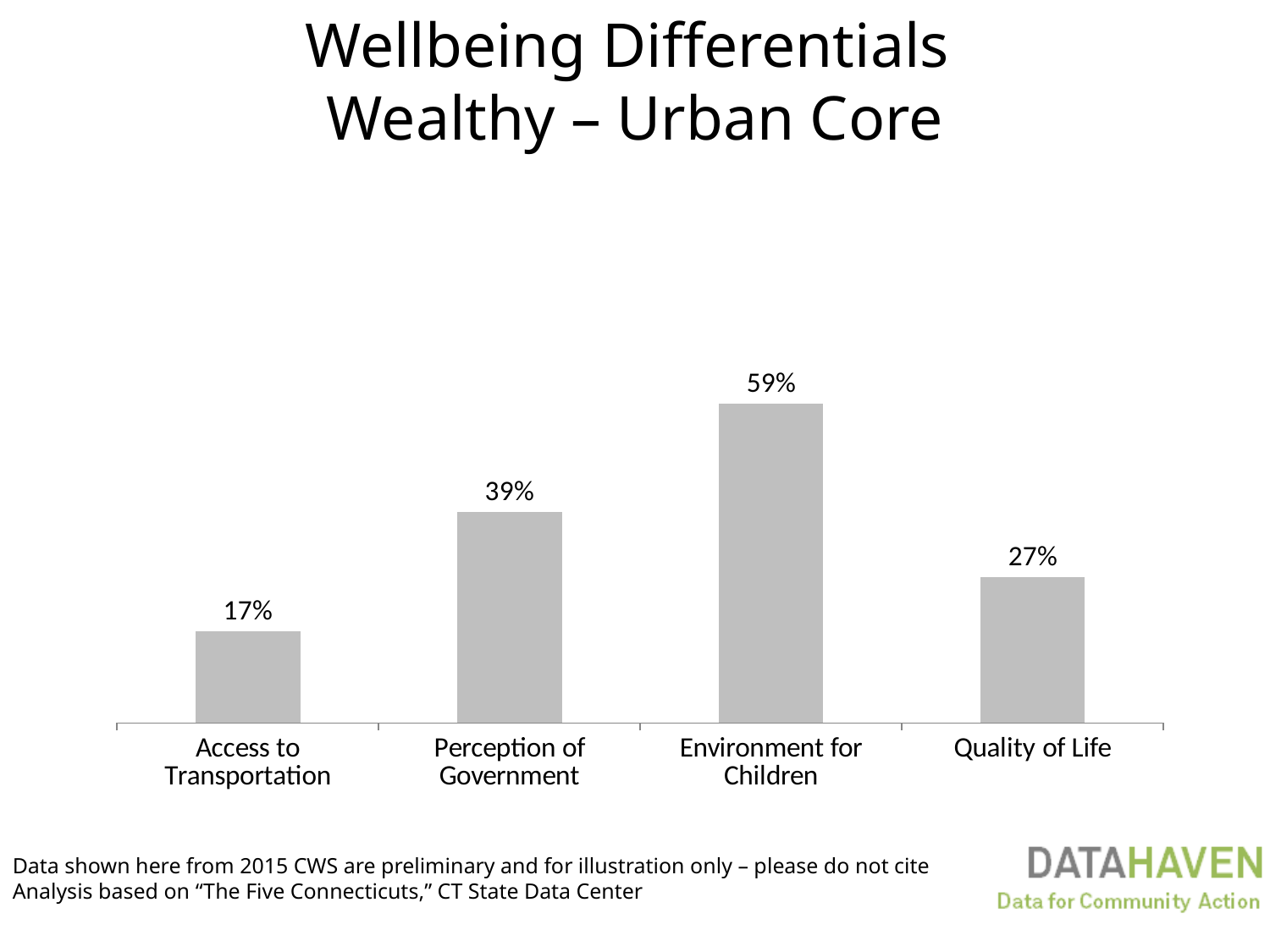
What is the value for Perception of Government? 39% What is the value for Quality of Life? 27% What is the difference between the values for Environment for Children and Perception of Government? 20% What is the title of the slide containing the chart? Wellbeing Differentials Wealthy – Urban Core How many categories are shown in the chart? 4 What is the difference between the values for Quality of Life and Access to Transportation? 10% What is the value for Access to Transportation? 17% What is the value for Environment for Children? 59% Which category has the lowest value? Access to Transportation Which is larger, the value for Perception of Government or the value for Quality of Life? Perception of Government Which category has the highest value? Environment for Children What kind of chart is shown on the slide? Bar chart